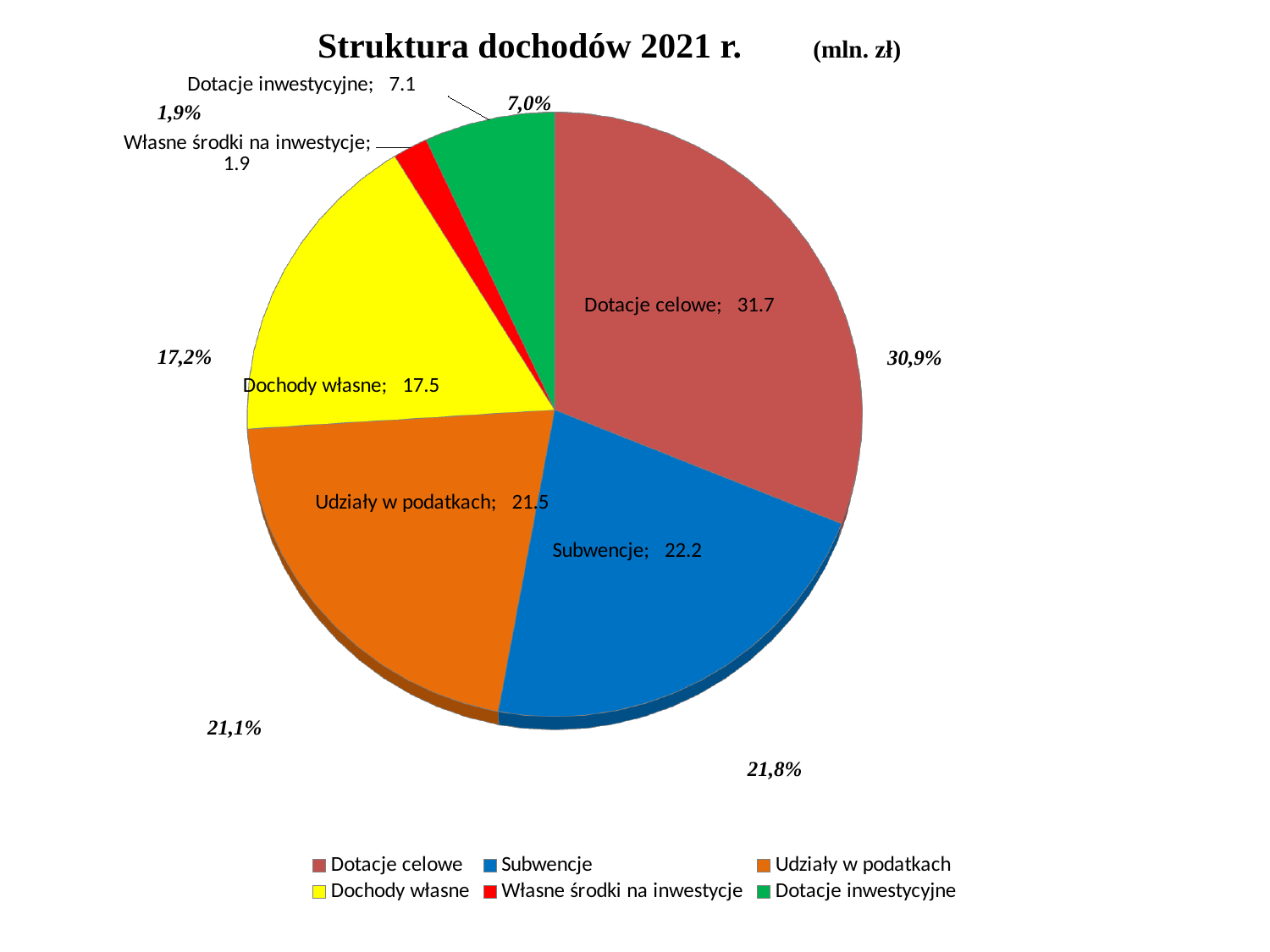
What is the value for Udziały w podatkach? 21.5 What is the difference between the values for Dotacje celowe and Subwencje? 9.5 How many slices does the pie chart have? 6 What percentage share of the pie does Dochody własne have? 17,2% Which category has the largest slice of the pie? Dotacje celowe What kind of chart is shown on the slide? pie chart What is the value for Własne środki na inwestycje? 1.9 Which is larger, the value for Dochody własne or the value for Dotacje inwestycyjne? Dochody własne What is the value for Subwencje? 22.2 Which category has the smallest slice of the pie? Własne środki na inwestycje What is the title of the chart? Struktura dochodów 2021 r. What is the value for Dotacje celowe? 31.7